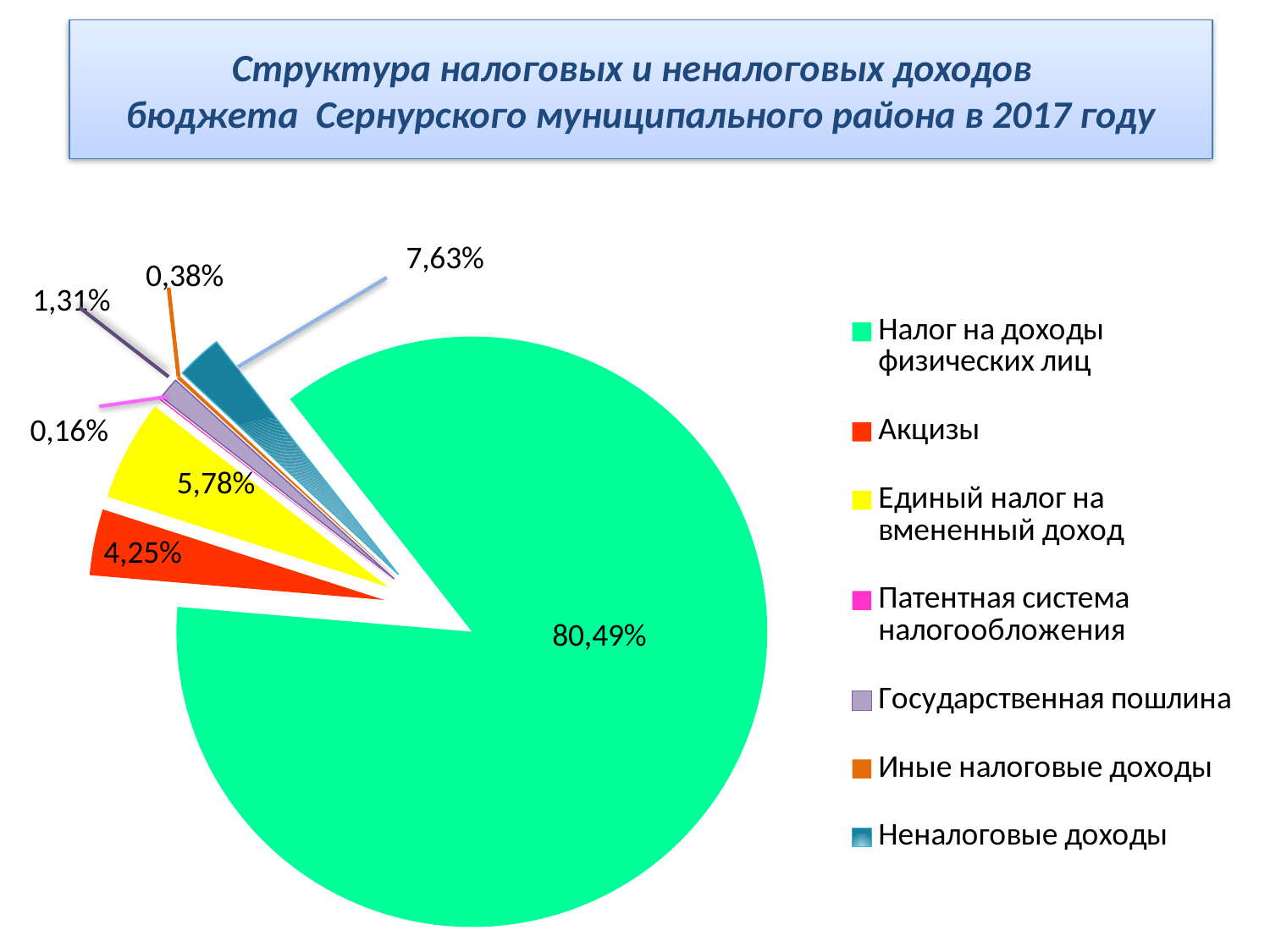
Which category has the smallest slice of the pie? Патентная система налогообложения Which category has the largest slice of the pie? Налог на доходы физических лиц What share of the pie does "Налог на доходы физических лиц" have? 80,49% How many categories does the legend list? 7 What colour is the slice for "Иные налоговые доходы"? orange What is the difference between the shares of "Неналоговые доходы" and "Акцизы"? 3,38% What type of chart is shown on the slide? pie chart What is the value shown for "Единый налог на вмененный доход"? 5,78% What is the value shown for "Акцизы"? 4,25% What is the value shown for "Государственная пошлина"? 1,31% Which is larger: "Акцизы" or "Единый налог на вмененный доход"? Единый налог на вмененный доход What is the value shown for "Неналоговые доходы"? 7,63%